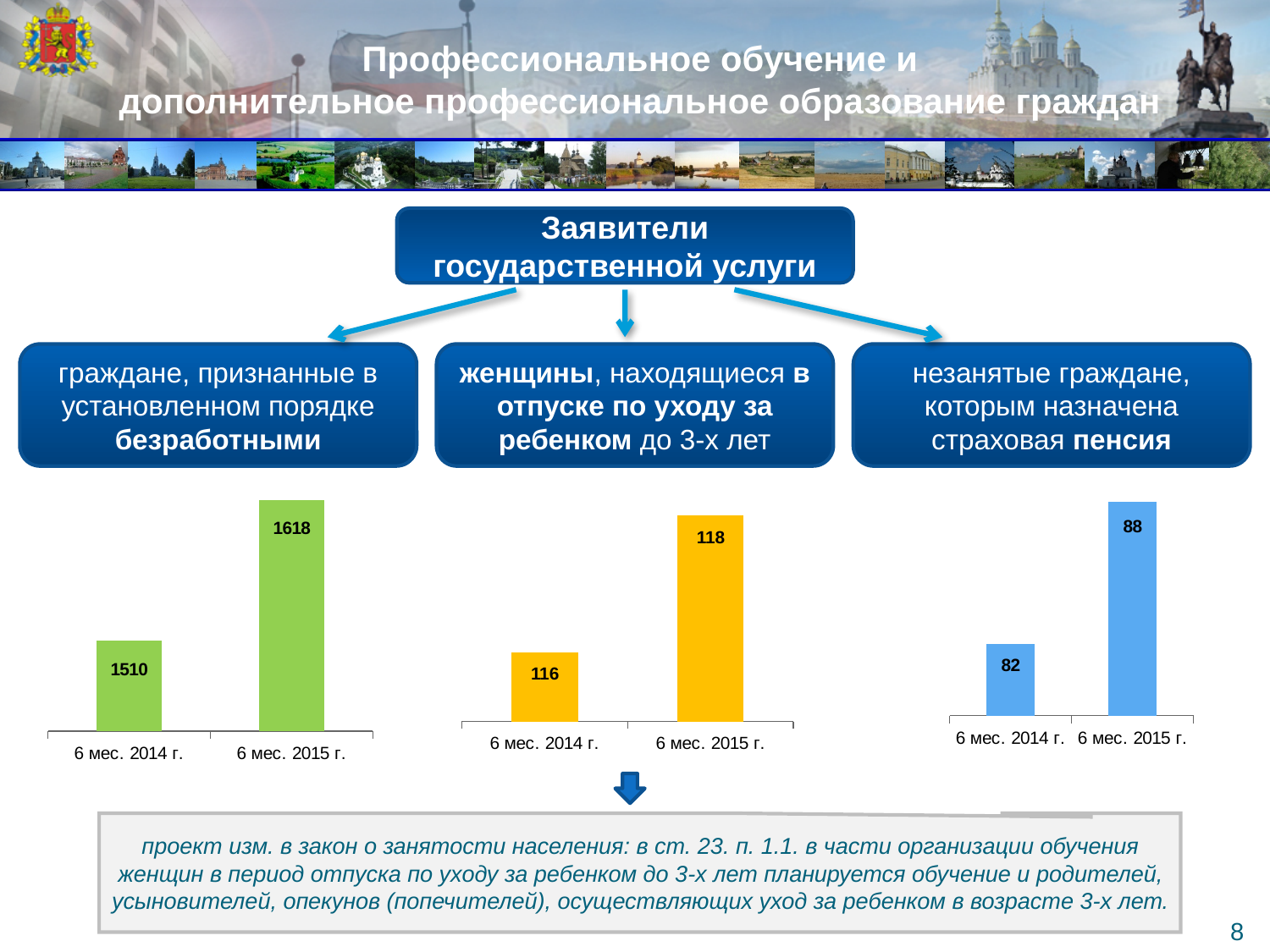
In the middle chart (yellow bars), do the values rise or fall from 6 мес. 2014 г. to 6 мес. 2015 г.? rise What kind of chart is the middle chart (yellow bars)? bar chart In the middle chart (yellow bars), what is the value for 6 мес. 2014 г.? 116 In the right chart (blue bars), what is the difference between the 6 мес. 2015 г. and 6 мес. 2014 г. values? 6 In the right chart (blue bars), what is the value for 6 мес. 2015 г.? 88 In the right chart (blue bars), which period has the higher value? 6 мес. 2015 г. In the left chart (green bars), which period has the lower value? 6 мес. 2014 г. In the left chart (green bars), what is the value for 6 мес. 2015 г.? 1618 How many categories are shown on the x axis of the right chart (blue bars)? 2 In the left chart (green bars), what is the value for 6 мес. 2014 г.? 1510 In the middle chart (yellow bars), what is the difference between the 6 мес. 2015 г. and 6 мес. 2014 г. values? 2 In the left chart (green bars), what is the difference between the 6 мес. 2015 г. and 6 мес. 2014 г. values? 108